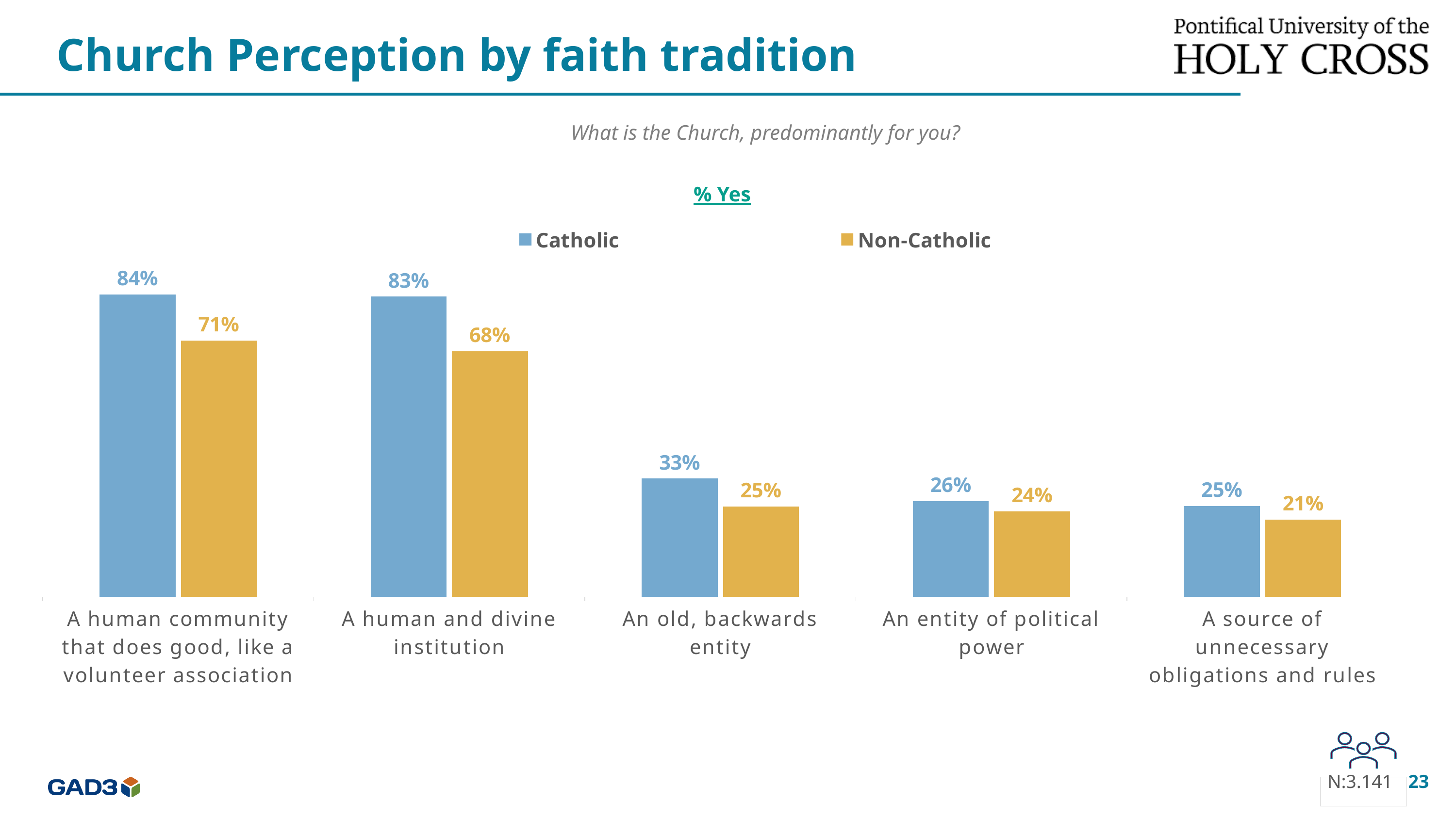
What kind of chart is shown on the slide? Bar chart Which category has the highest Catholic value? A human community that does good, like a volunteer association How many categories are shown on the x axis? 5 What is the Non-Catholic value for 'A source of unnecessary obligations and rules'? 21% What percentage of Catholics see the Church as a human community that does good, like a volunteer association? 84% Which category has the lowest Non-Catholic value? A source of unnecessary obligations and rules What is the difference between the Catholic and Non-Catholic values for 'A human and divine institution'? 15 percentage points What is the difference between the Catholic and Non-Catholic values for 'An old, backwards entity'? 8 percentage points What is the Non-Catholic value for 'A human and divine institution'? 68% For 'An entity of political power', which is larger: the Catholic or the Non-Catholic value? Catholic How many series does the legend list? 2 What is the Catholic value for 'An entity of political power'? 26%